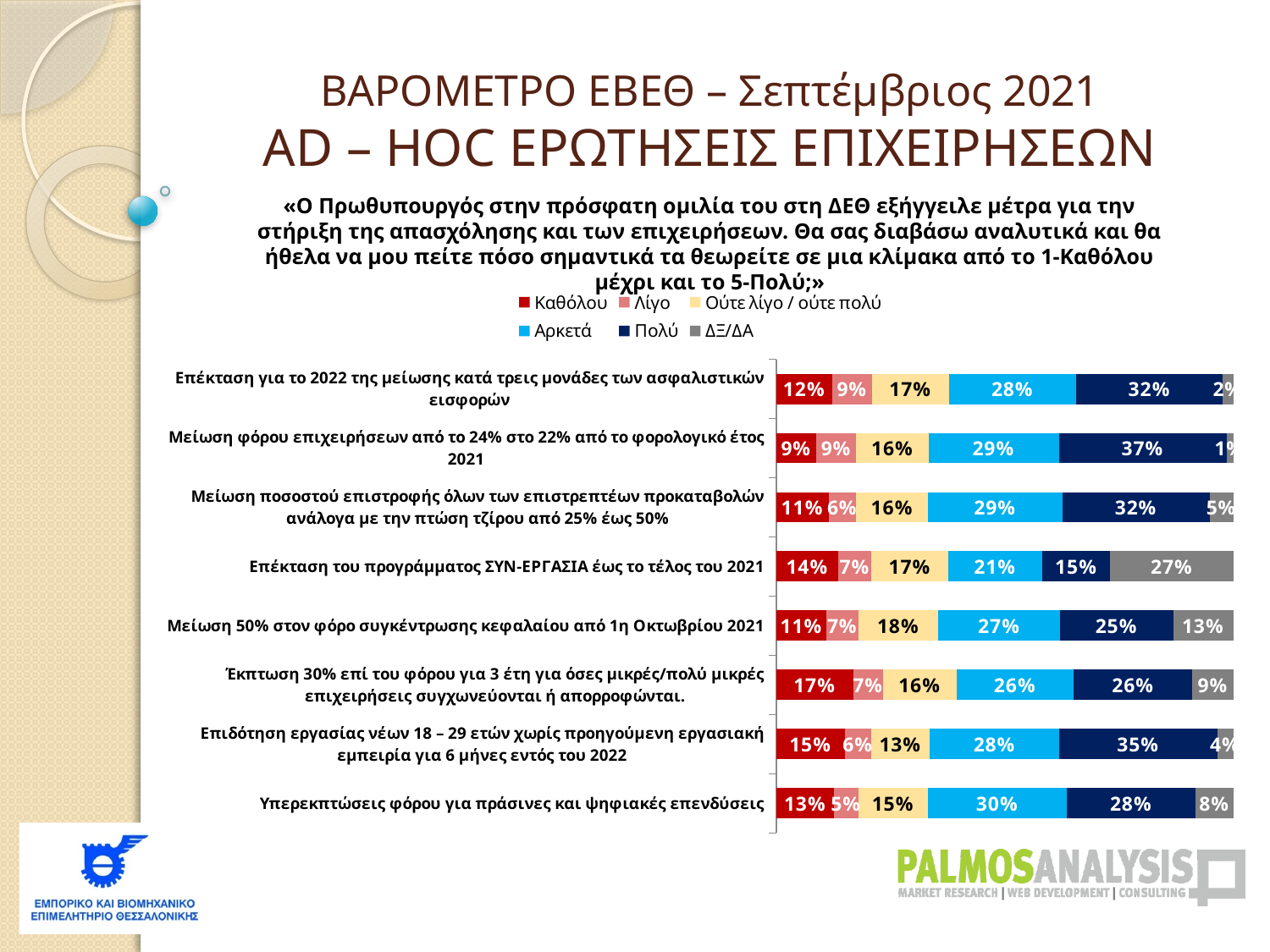
What is the difference between the "Πολύ" values for "Επιδότηση εργασίας νέων 18 – 29 ετών χωρίς προηγούμενη εργασιακή εμπειρία για 6 μήνες εντός του 2022" and "Μείωση 50% στον φόρο συγκέντρωσης κεφαλαίου από 1η Οκτωβρίου 2021"? 10% How many measures (categories) are plotted in the chart? 8 Which measure has the lowest "Πολύ" value? Επέκταση του προγράμματος ΣΥΝ-ΕΡΓΑΣΙΑ έως το τέλος του 2021 Which is larger for "Μείωση 50% στον φόρο συγκέντρωσης κεφαλαίου από 1η Οκτωβρίου 2021": the "Αρκετά" value or the "Πολύ" value? Αρκετά What is the value of "ΔΞ/ΔΑ" for "Επέκταση του προγράμματος ΣΥΝ-ΕΡΓΑΣΙΑ έως το τέλος του 2021"? 27% What is the value of "Καθόλου" for "Έκπτωση 30% επί του φόρου για 3 έτη για όσες μικρές/πολύ μικρές επιχειρήσεις συγχωνεύονται ή απορροφώνται"? 17% What kind of chart is shown on the slide? Stacked bar chart How many series does the legend list? 6 Which measure has the highest "Πολύ" value? Μείωση φόρου επιχειρήσεων από το 24% στο 22% από το φορολογικό έτος 2021 What is the value of "Αρκετά" for "Υπερεκπτώσεις φόρου για πράσινες και ψηφιακές επενδύσεις"? 30% What is the value of "Πολύ" for "Μείωση φόρου επιχειρήσεων από το 24% στο 22% από το φορολογικό έτος 2021"? 37% Which legend entry is shown in red? Καθόλου